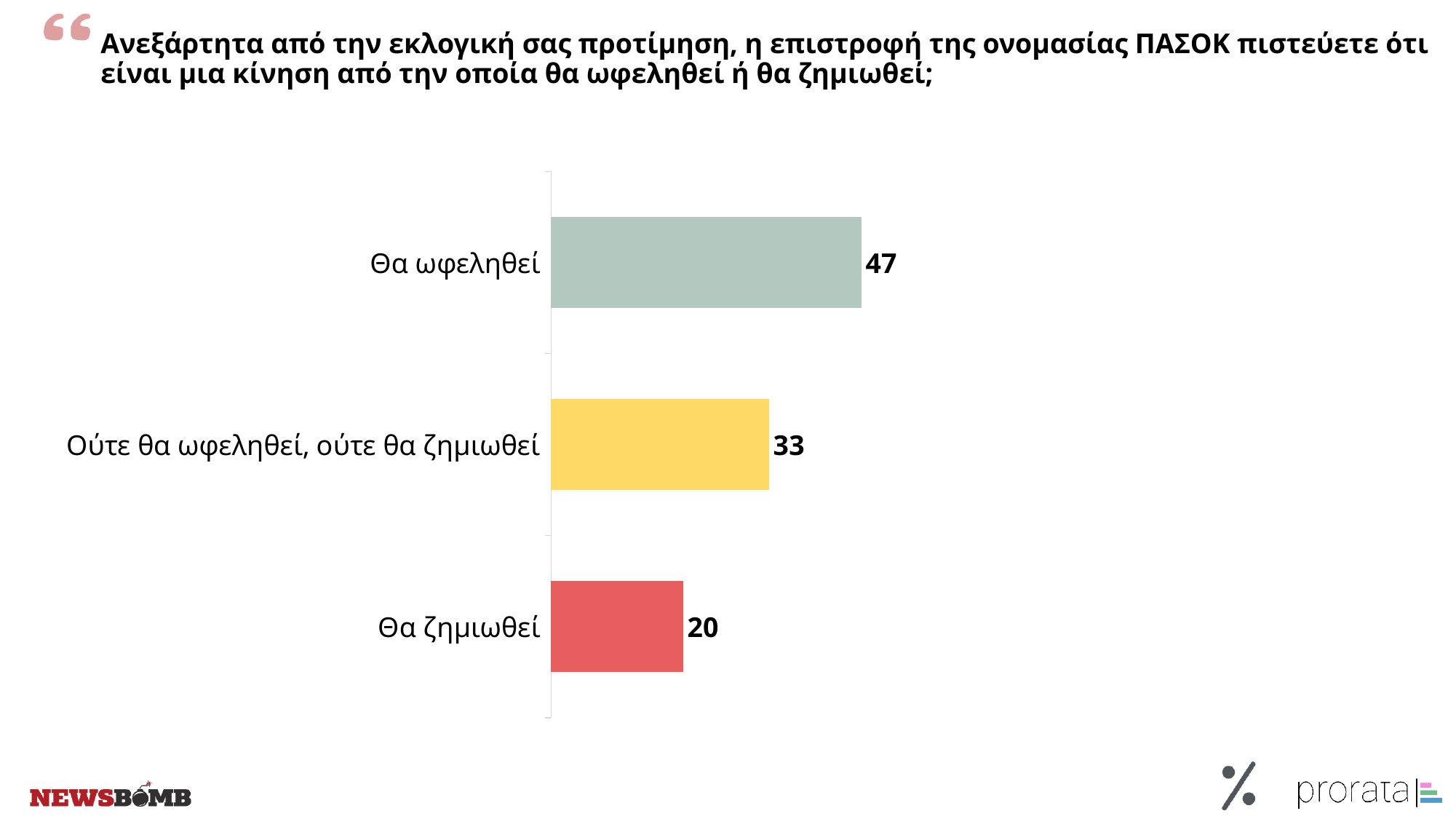
What is the difference between the values for "Θα ωφεληθεί" and "Ούτε θα ωφεληθεί, ούτε θα ζημιωθεί"? 14 Which category has the lowest value? Θα ζημιωθεί What colour is the bar for "Θα ζημιωθεί"? Red What colour is the bar for "Ούτε θα ωφεληθεί, ούτε θα ζημιωθεί"? Yellow What is the value for "Θα ζημιωθεί"? 20 Which category has the highest value? Θα ωφεληθεί What is the difference between the values for "Θα ωφεληθεί" and "Θα ζημιωθεί"? 27 What kind of chart is shown on the slide? Bar chart What is the value for "Ούτε θα ωφεληθεί, ούτε θα ζημιωθεί"? 33 What is the value for "Θα ωφεληθεί"? 47 Which is larger, the value for "Ούτε θα ωφεληθεί, ούτε θα ζημιωθεί" or the value for "Θα ζημιωθεί"? Ούτε θα ωφεληθεί, ούτε θα ζημιωθεί How many categories are shown in the chart? 3